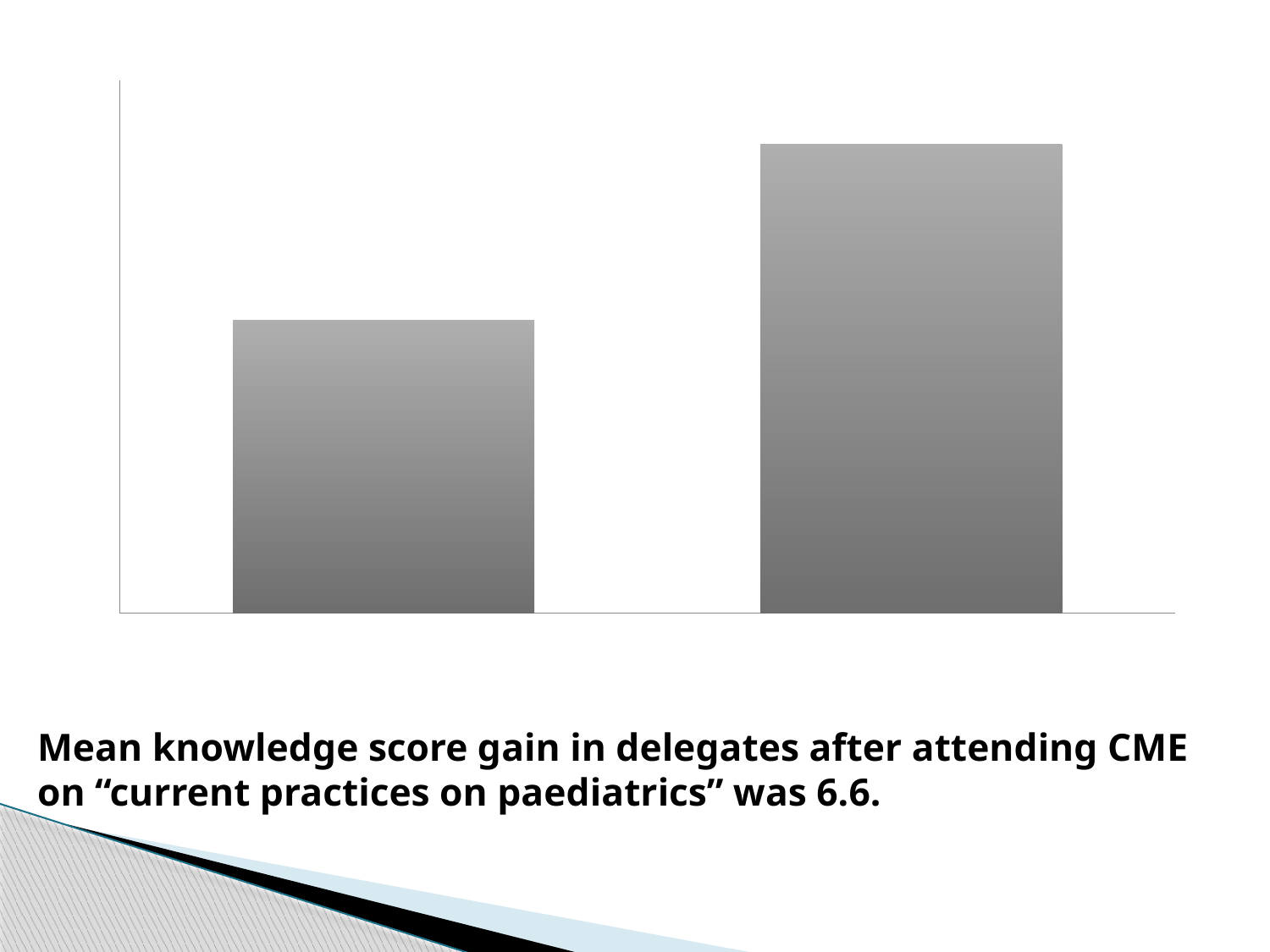
Which bar is taller, the left bar or the right bar? the right bar Do the bar values rise or fall from left to right across the chart? rise How many bars are plotted in the chart? 2 Does the chart display a legend? No Are the bars in the chart vertical or horizontal? vertical Which bar represents the lowest value, the left or the right? the left bar What kind of chart is shown on the slide? bar chart